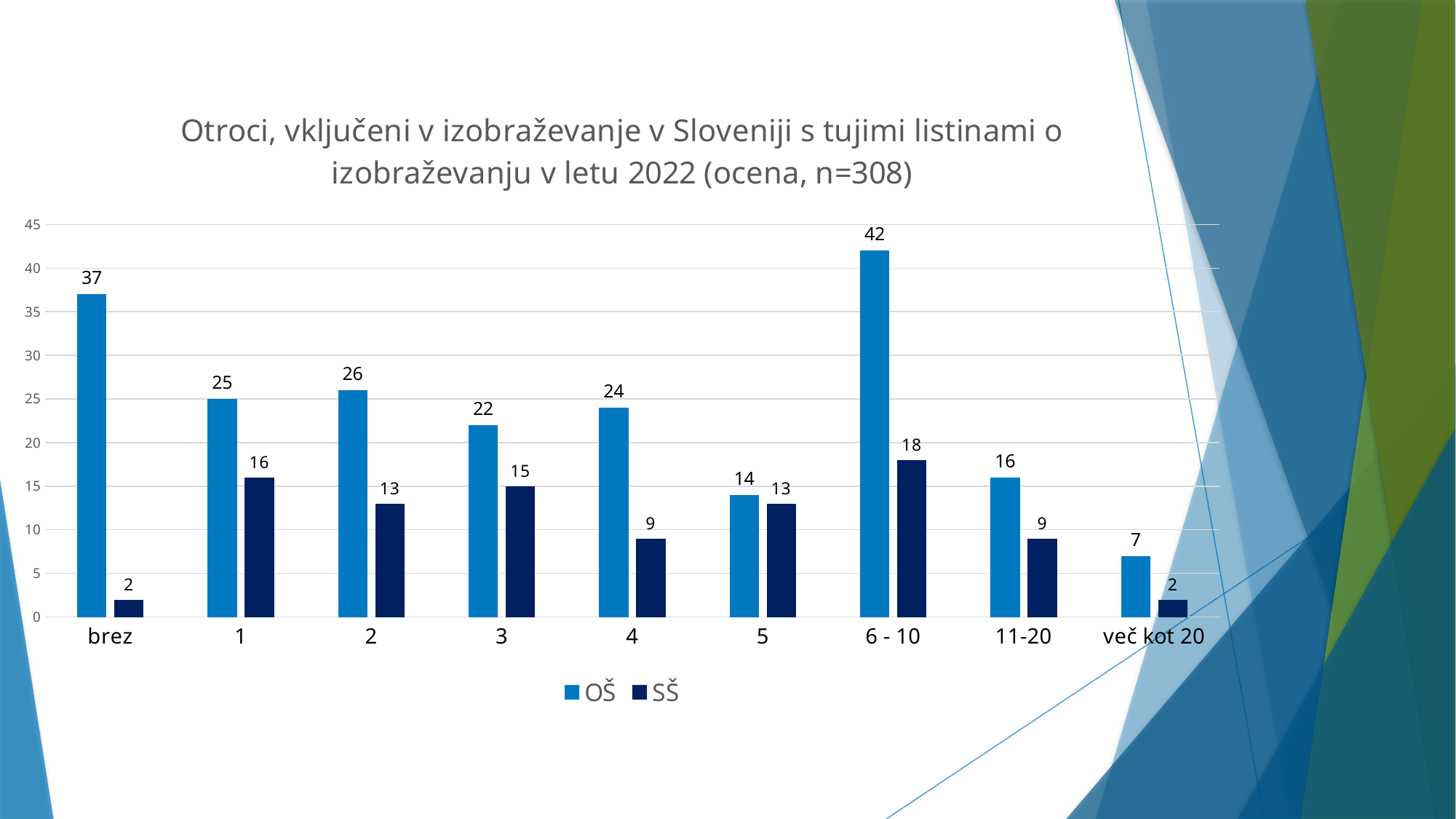
How many series does the legend list? 2 What kind of chart is shown on the slide? bar chart What is the SŠ value for the category '1'? 16 Which is larger for the category '5': the OŠ value or the SŠ value? OŠ Which category has the lowest OŠ value? več kot 20 What is the OŠ value for the category 'brez'? 37 What is the difference between the OŠ values for '6 - 10' and '11-20'? 26 What is the difference between the OŠ and SŠ values for the category 'brez'? 35 Which category has the highest OŠ value? 6 - 10 What is the OŠ value for the category '6 - 10'? 42 How many categories are shown on the x axis? 9 What are the two series listed in the legend? OŠ and SŠ